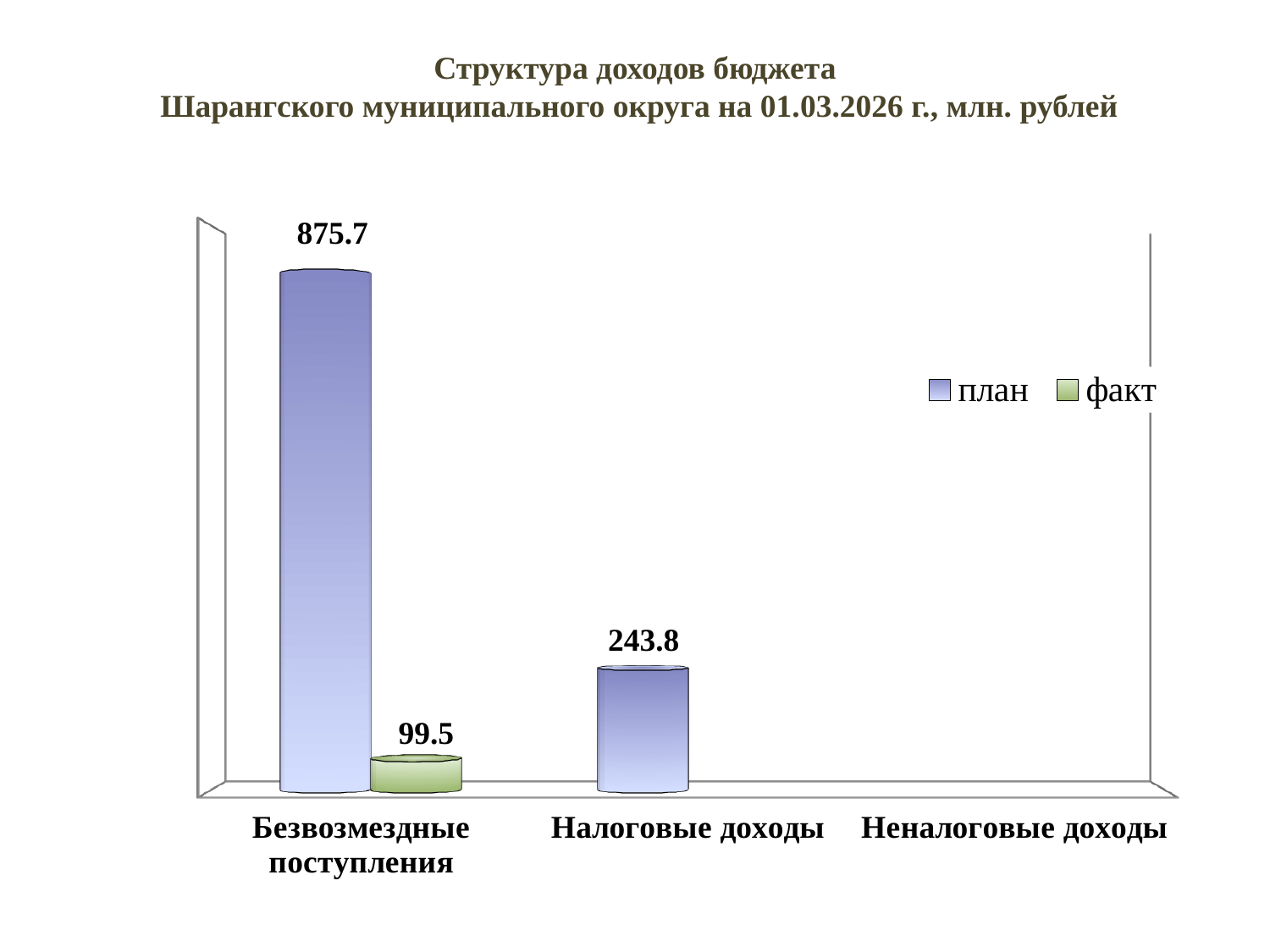
What unit is stated in the chart title? млн. рублей What kind of chart is shown on the slide? bar chart Which category has the highest план value? Безвозмездные поступления What is the план value for Налоговые доходы? 243.8 What are the two series named in the legend? план and факт What is the план value for Безвозмездные поступления? 875.7 How many series does the legend list? 2 How many categories are shown on the x axis? 3 What is the difference between the план values for Безвозмездные поступления and Налоговые доходы? 631.9 Which is larger: the план value for Налоговые доходы or the факт value for Безвозмездные поступления? план value for Налоговые доходы What is the факт value for Безвозмездные поступления? 99.5 What is the difference between the план and факт values for Безвозмездные поступления? 776.2